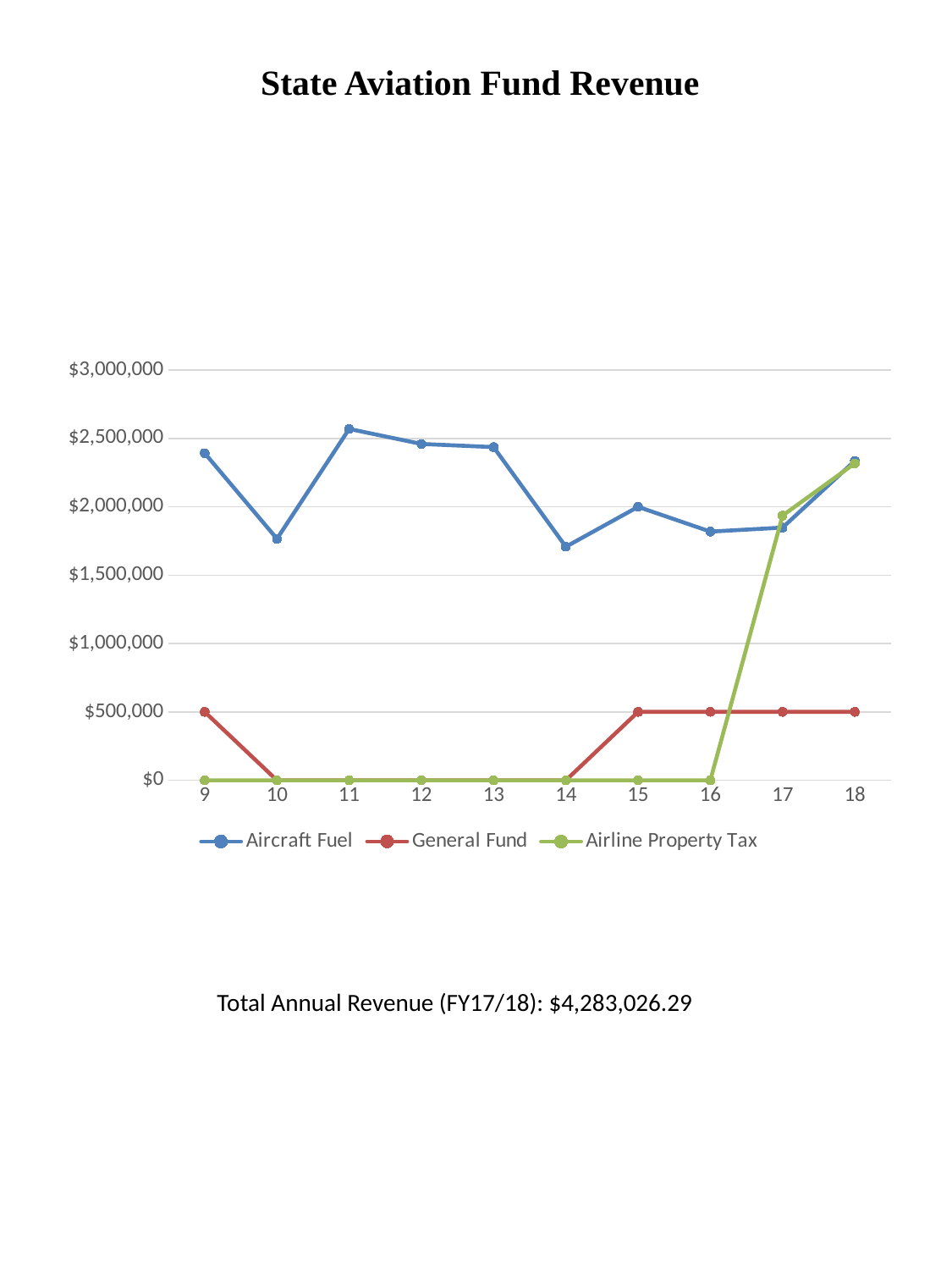
Is the Aircraft Fuel value at 14 greater or less than $2,000,000? less Which is larger for Aircraft Fuel, the value at 9 or the value at 10? 9 What is the General Fund value at 9? $500,000 How many series does the legend list? 3 At which x-axis point is Aircraft Fuel highest? 11 What is the Airline Property Tax value at 12? $0 Is the Airline Property Tax value at 17 greater or less than $1,500,000? greater What kind of chart is shown on the slide? line chart Is the Aircraft Fuel value at 11 greater or less than $2,500,000? greater Does the Airline Property Tax line rise or fall from 16 to 18? rise How many points are plotted along the x axis for each series? 10 What is the General Fund value at 16? $500,000